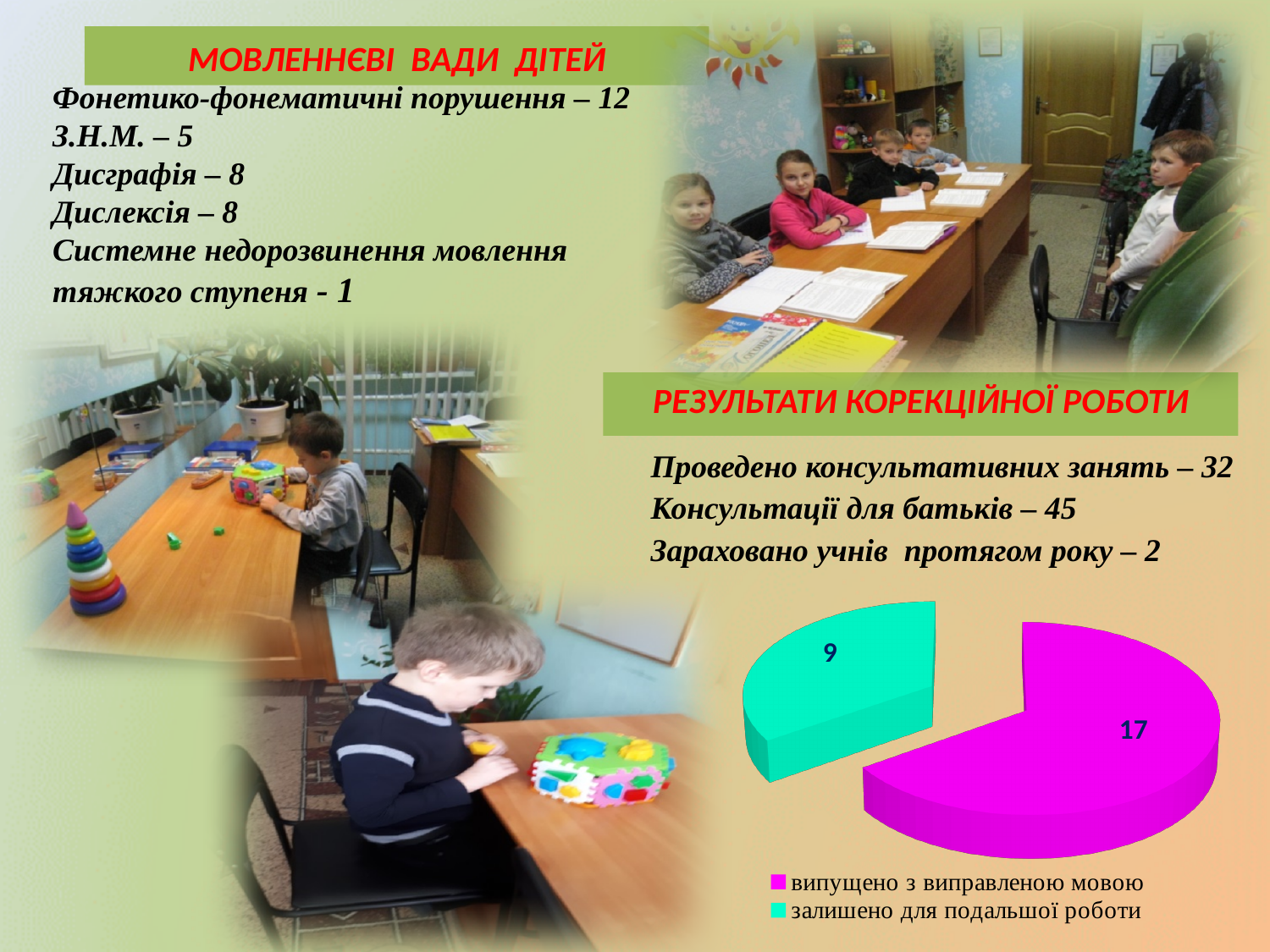
In the pie chart, what is the value for "залишено для подальшої роботи"? 9 What fraction of the pie chart total does "випущено з виправленою мовою" represent? 17 out of 26 Which is larger in the pie chart: "випущено з виправленою мовою" or "залишено для подальшої роботи"? випущено з виправленою мовою Which category in the pie chart has the largest value? випущено з виправленою мовою Which category in the pie chart has the smallest value? залишено для подальшої роботи In the pie chart, what is the value for "випущено з виправленою мовою"? 17 What colour is the slice for "залишено для подальшої роботи" in the pie chart? cyan (turquoise) What is the difference between the two values shown in the pie chart? 8 What type of chart is shown on the slide? pie chart How many entries does the legend of the pie chart list? 2 What is the total of the two values shown in the pie chart? 26 How many slices does the pie chart have? 2